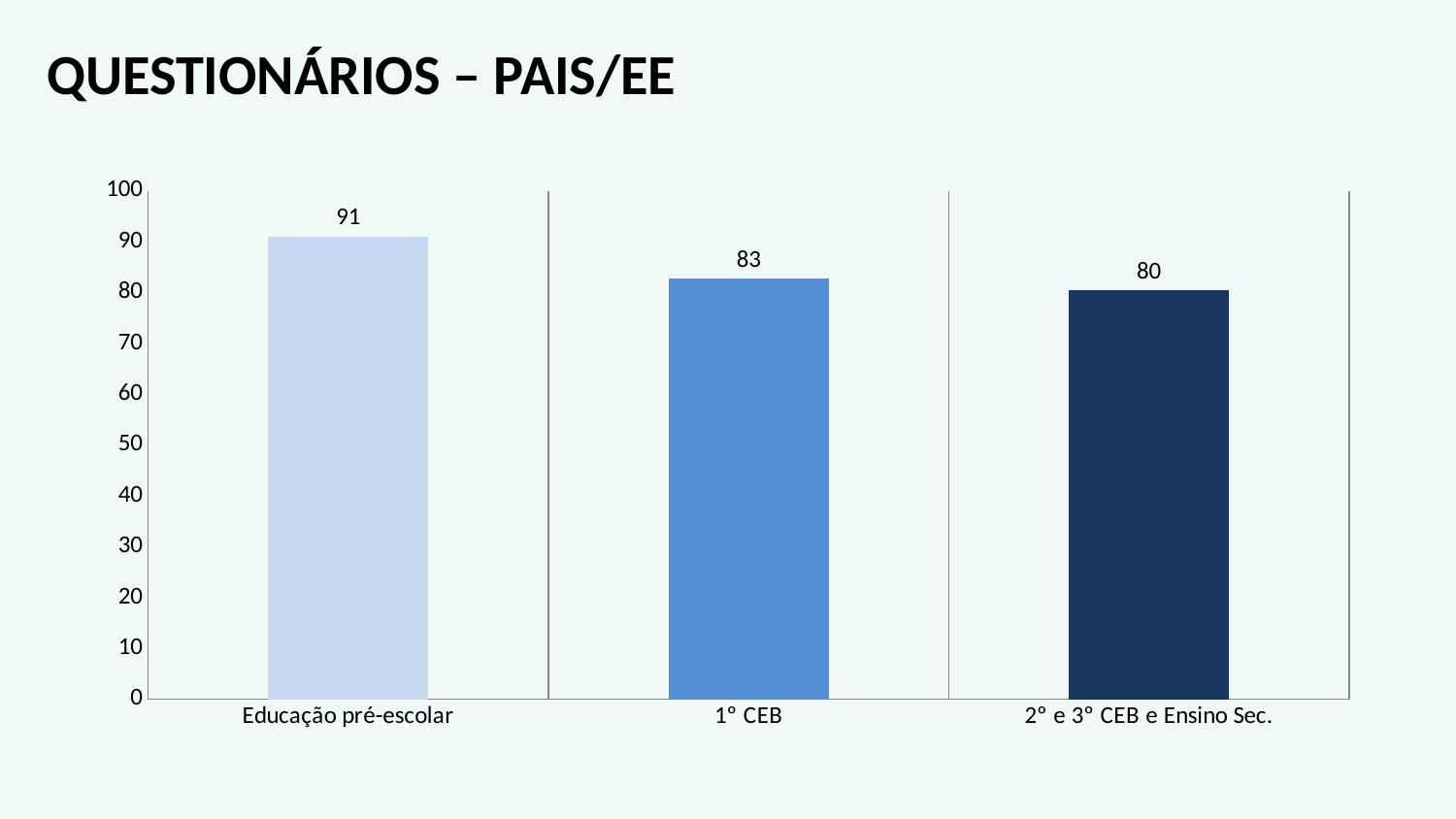
How many categories are shown on the chart? 3 What is the value for 1° CEB? 83 Which is larger, the value for Educação pré-escolar or the value for 2° e 3° CEB e Ensino Sec.? Educação pré-escolar What is the difference between the values for Educação pré-escolar and 1° CEB? 8 What is the value for Educação pré-escolar? 91 What kind of chart is shown on the slide? bar chart What is the value for 2° e 3° CEB e Ensino Sec.? 80 Do the values rise or fall from left to right across the categories? fall Which category has the highest value? Educação pré-escolar Is the value for 1° CEB greater or less than 90? less What is the difference between the values for 1° CEB and 2° e 3° CEB e Ensino Sec.? 3 Which category has the lowest value? 2° e 3° CEB e Ensino Sec.